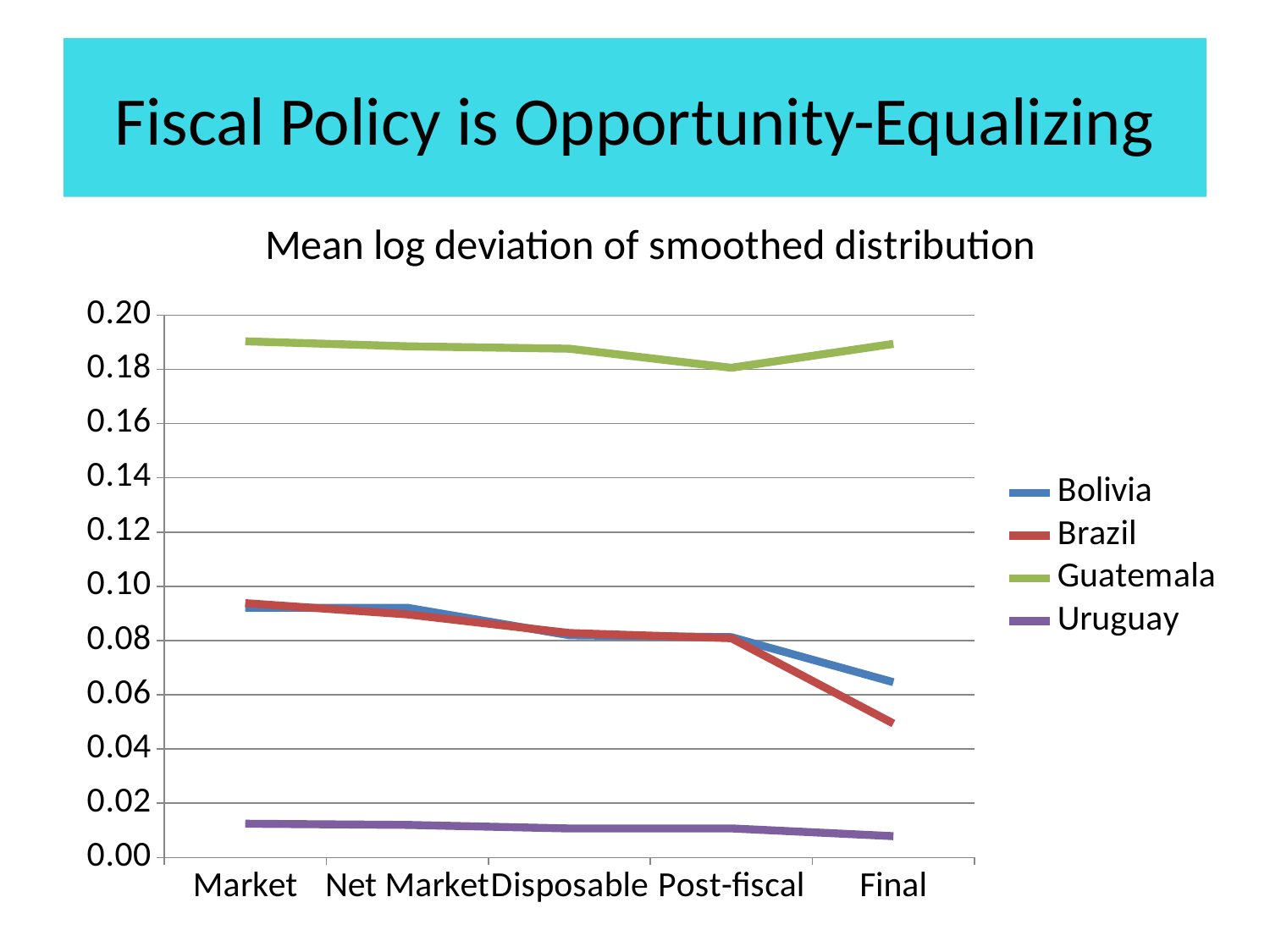
Is the value for Brazil at Final greater or less than 0.06? less Is the value for Uruguay at Market greater or less than 0.02? less How many categories are shown on the x axis? 5 Does the Brazil line rise or fall from Market to Final? fall For Guatemala, which category has the lowest value? Post-fiscal Is the value for Guatemala at Market greater or less than 0.18? greater Which series has the lowest value at the Market category? Uruguay Which series has the highest value at the Final category? Guatemala What kind of chart is shown on the slide? line chart For Brazil, which category has the lowest value? Final How many series does the legend list? 4 At the Final category, which is larger: Bolivia or Brazil? Bolivia